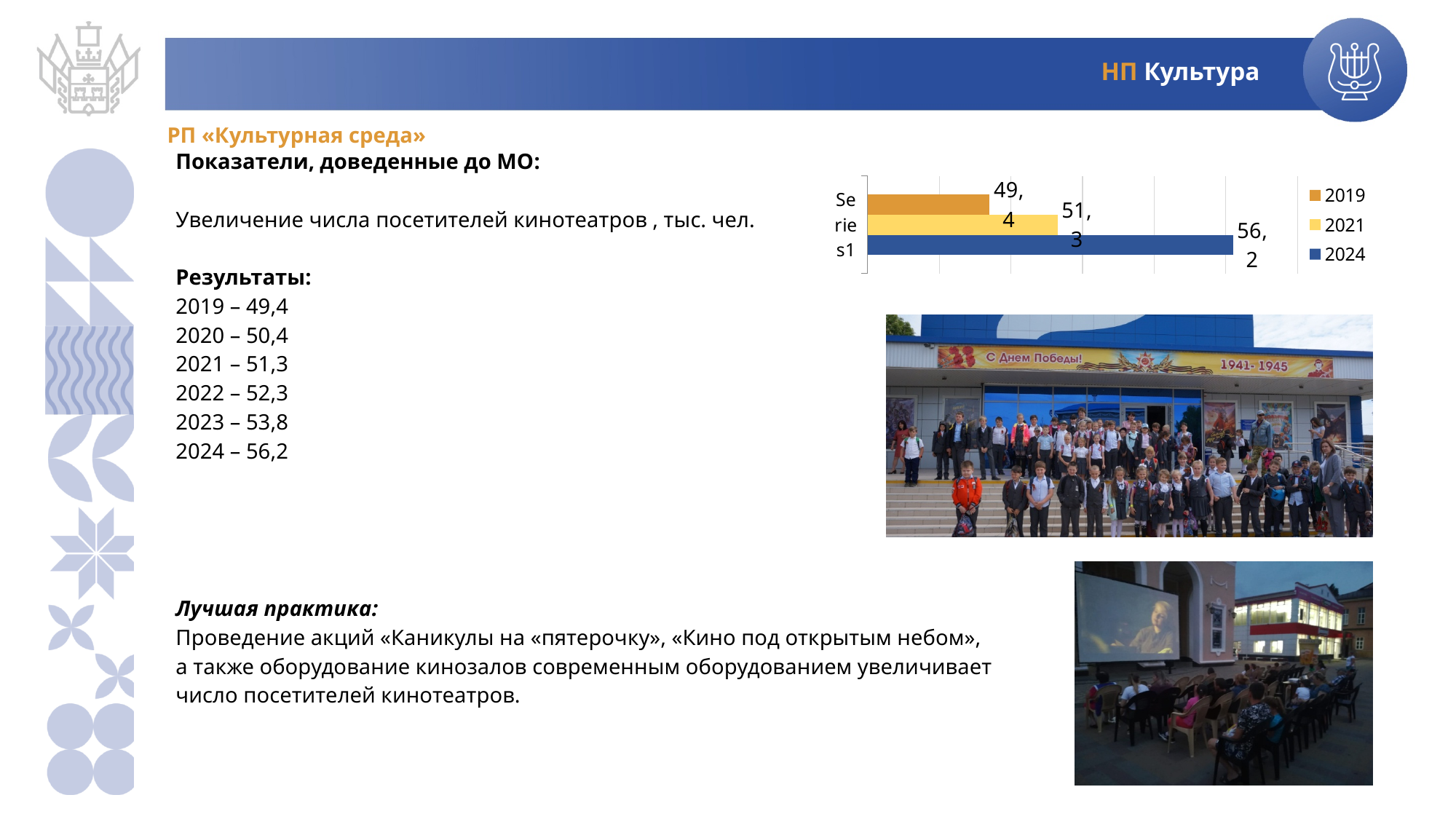
What kind of chart is shown on the slide? bar chart What is the value of the 2024 bar in the chart? 56,2 What colour is the 2024 series in the chart? blue Which series has the lowest value in the chart? 2019 Do the values in the chart rise or fall from 2019 to 2024? rise How many series does the chart legend list? 3 What is the value of the 2021 bar in the chart? 51,3 Which series has the highest value in the chart? 2024 What is the value of the 2019 bar in the chart? 49,4 What is the difference between the 2021 and 2019 values in the chart? 1,9 What is the difference between the 2024 and 2019 values in the chart? 6,8 Which is larger in the chart, the 2021 value or the 2024 value? 2024